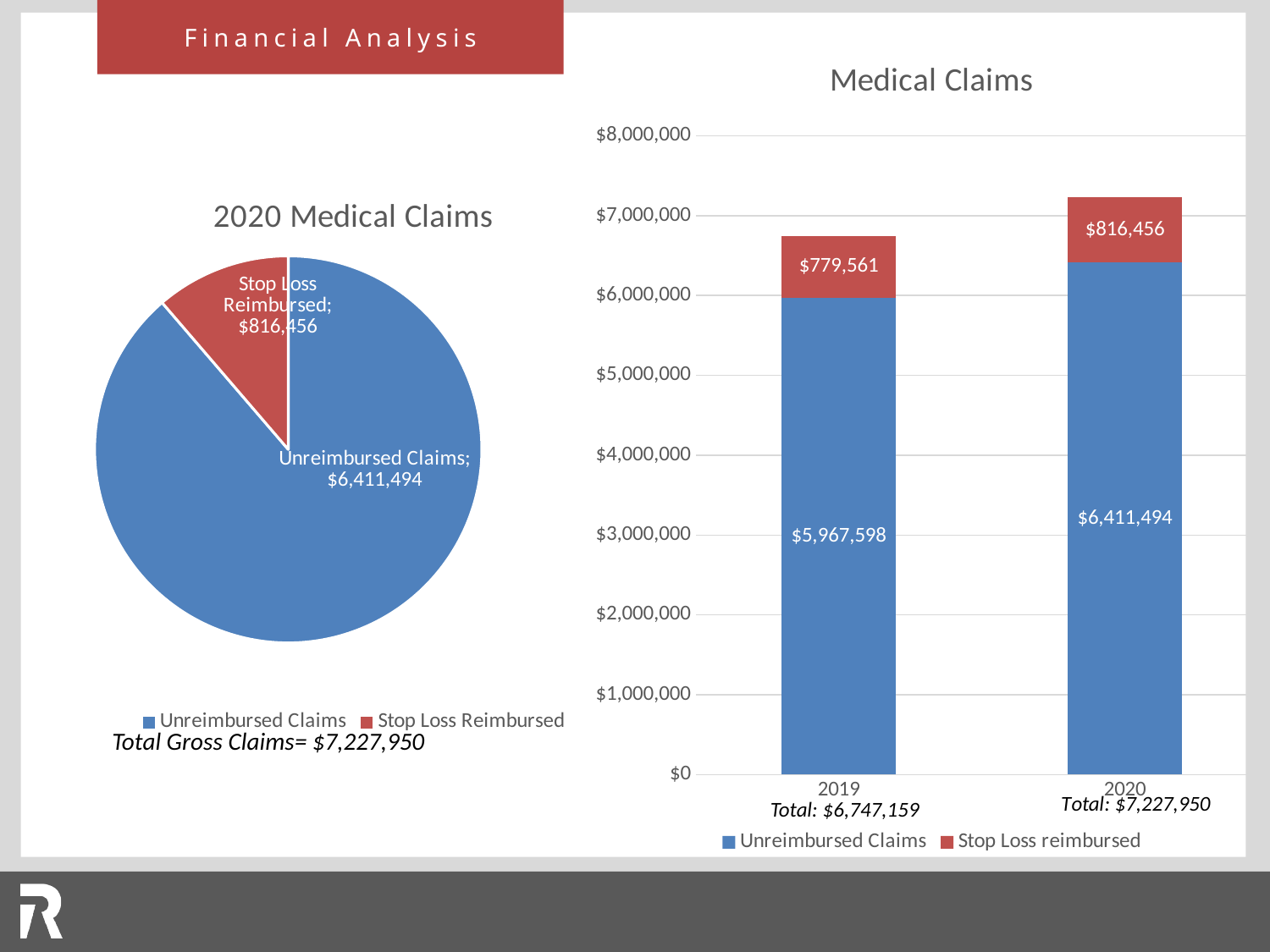
In the Medical Claims bar chart, how many series does the legend list? 2 In the 2020 Medical Claims pie chart, what is the value of Stop Loss Reimbursed? $816,456 In the Medical Claims bar chart, what is the value of Stop Loss reimbursed for 2020? $816,456 In the Medical Claims bar chart, what is the value of Unreimbursed Claims for 2019? $5,967,598 In the Medical Claims bar chart, what is the difference in Stop Loss reimbursed between 2020 and 2019? $36,895 What kind of chart is the Medical Claims chart on the right? Stacked bar chart In the Medical Claims bar chart, how much higher is Unreimbursed Claims in 2020 than in 2019? $443,896 In the Medical Claims bar chart, which year has the larger Unreimbursed Claims value? 2020 In the 2020 Medical Claims pie chart, which slice is the largest? Unreimbursed Claims In the Medical Claims bar chart, what is the total of the stacked bar for 2020? $7,227,950 In the Medical Claims bar chart, what is the total of the stacked bar for 2019? $6,747,159